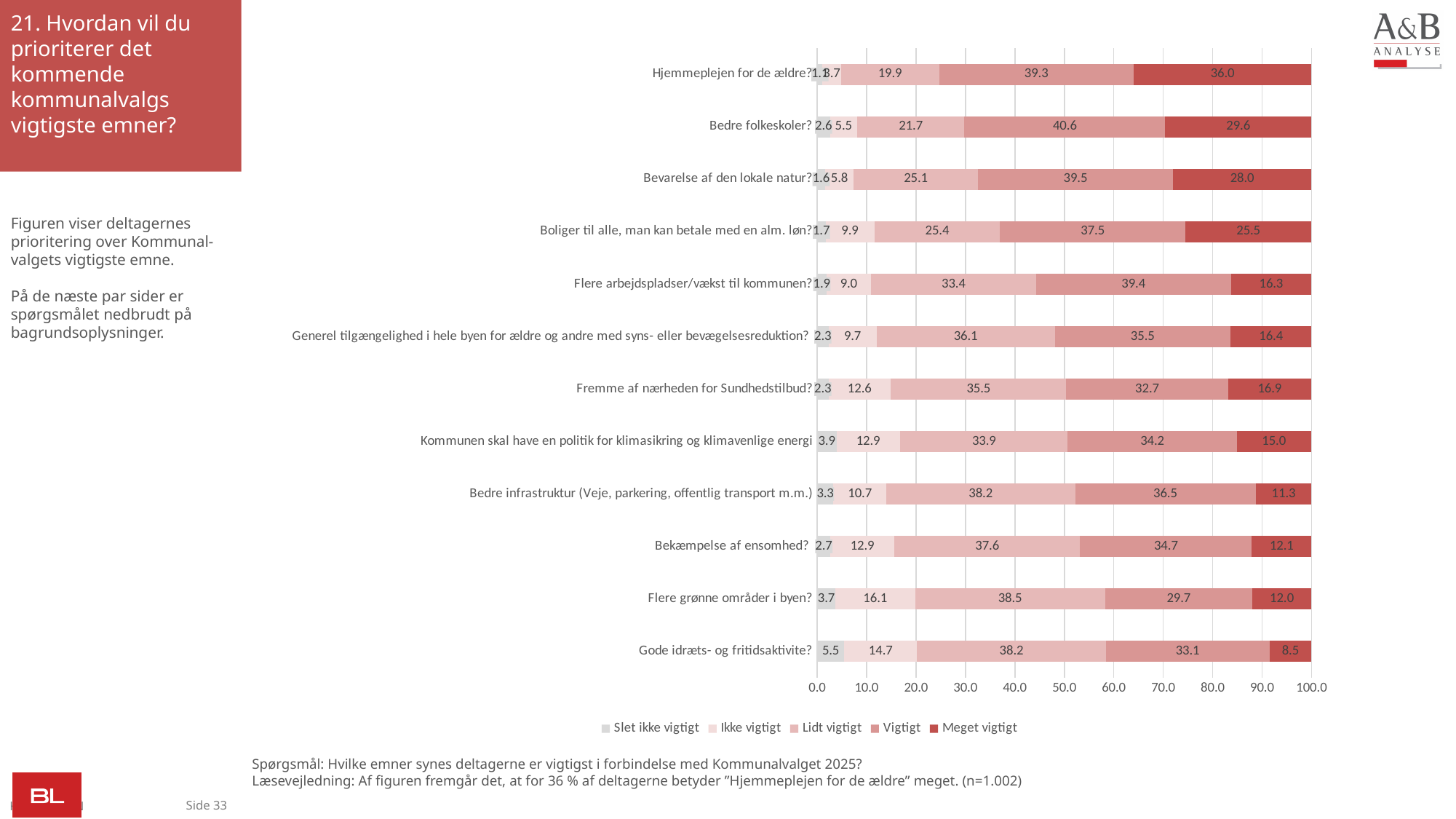
What is the value for "Slet ikke vigtigt" for "Gode idræts- og fritidsaktivite?"? 5.5 What is the value for "Lidt vigtigt" for "Flere grønne områder i byen?"? 38.5 What is the value for "Vigtigt" for "Bedre folkeskoler?"? 40.6 What kind of chart is shown on the slide? Stacked bar chart Which category has the highest "Meget vigtigt" value? Hjemmeplejen for de ældre? How many categories are shown in the chart? 12 What is the first entry in the chart's legend? Slet ikke vigtigt Which has the larger "Vigtigt" value: "Bedre folkeskoler?" or "Flere grønne områder i byen?"? Bedre folkeskoler? What is the difference between the "Meget vigtigt" values for "Hjemmeplejen for de ældre?" and "Bedre folkeskoler?"? 6.4 What is the value for "Meget vigtigt" for "Hjemmeplejen for de ældre?"? 36.0 Which category has the lowest "Meget vigtigt" value? Gode idræts- og fritidsaktivite? How many series does the legend list? 5